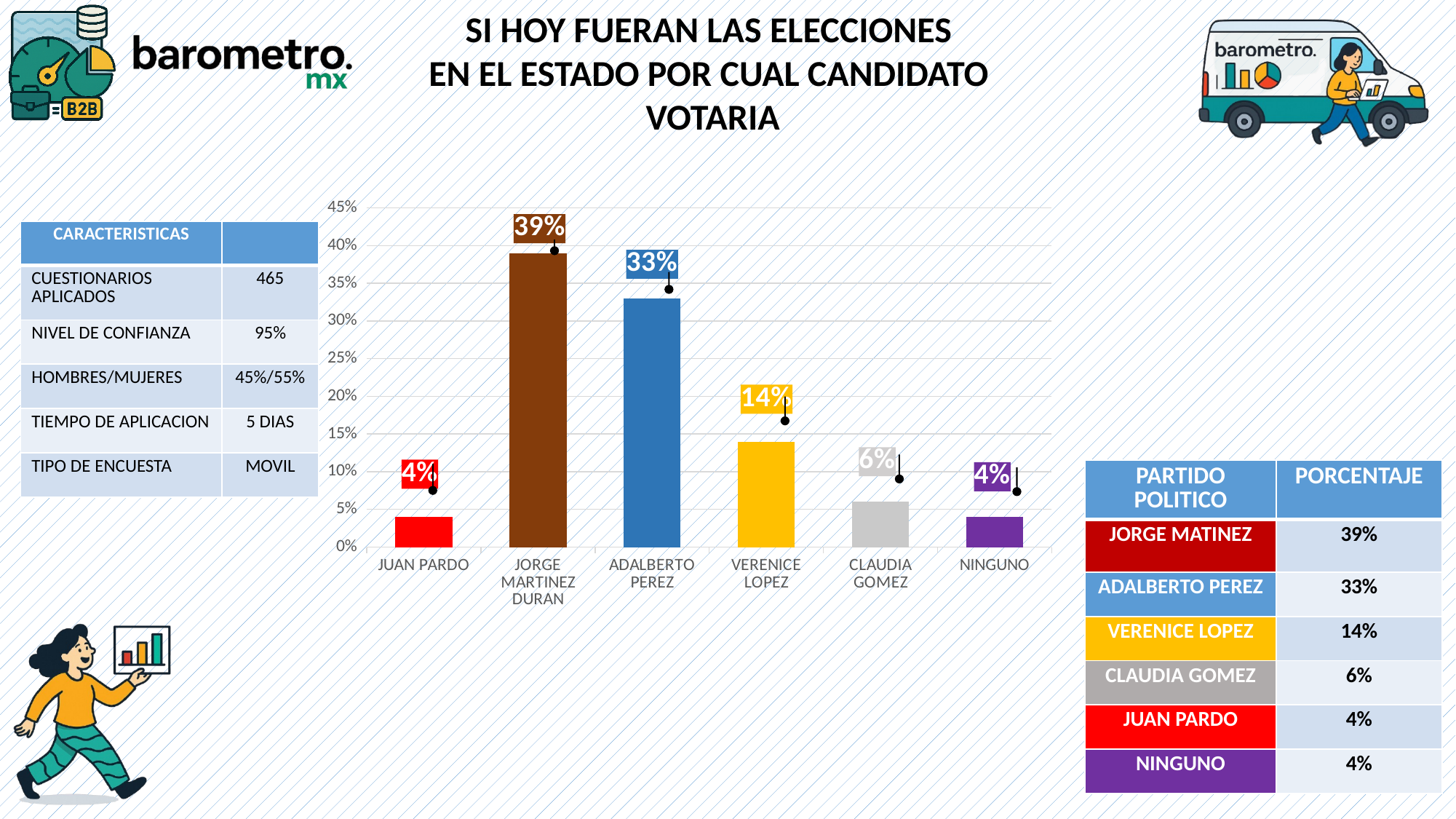
What is the highest value shown on the chart's y axis? 45% What value is shown for Claudia Gomez? 6% Which is larger, the value for Claudia Gomez or the value for Juan Pardo? Claudia Gomez Which candidate has the highest percentage in the chart? Jorge Martinez Duran What is the difference between Verenice Lopez and Claudia Gomez? 8% What value is shown for Verenice Lopez? 14% What is the difference in percentage points between Jorge Martinez Duran and Adalberto Perez? 6% How many categories are shown on the x axis of the chart? 6 What percentage of respondents would vote for Adalberto Perez? 33% Is the value for Adalberto Perez greater or less than 30%? greater What percentage of respondents would vote for Jorge Martinez Duran? 39% What kind of chart is shown on the slide? Bar chart